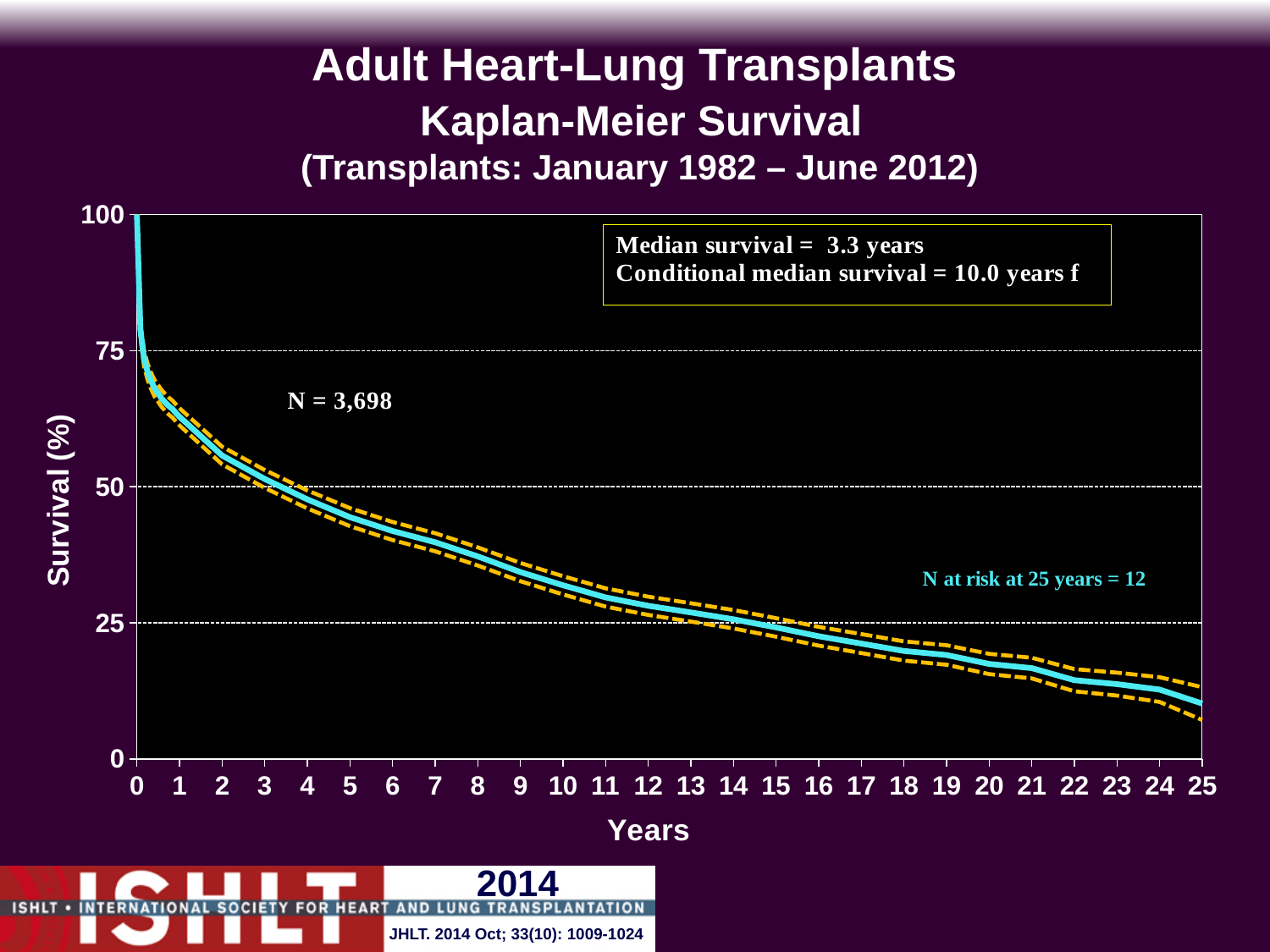
What is the N at risk at 25 years? 12 What is the maximum value shown on the x axis (Years)? 25 Is the survival at 10 years greater or less than 25%? greater Does survival rise or fall as years increase? fall What is the label of the y axis? Survival (%) What is the median survival shown on the chart? 3.3 years What is the value of N shown on the chart? 3,698 Is the survival at 20 years greater or less than 25%? less Is the survival at 1 year greater or less than 50%? greater What kind of chart is shown on the slide? line chart What is the conditional median survival shown on the chart? 10.0 years